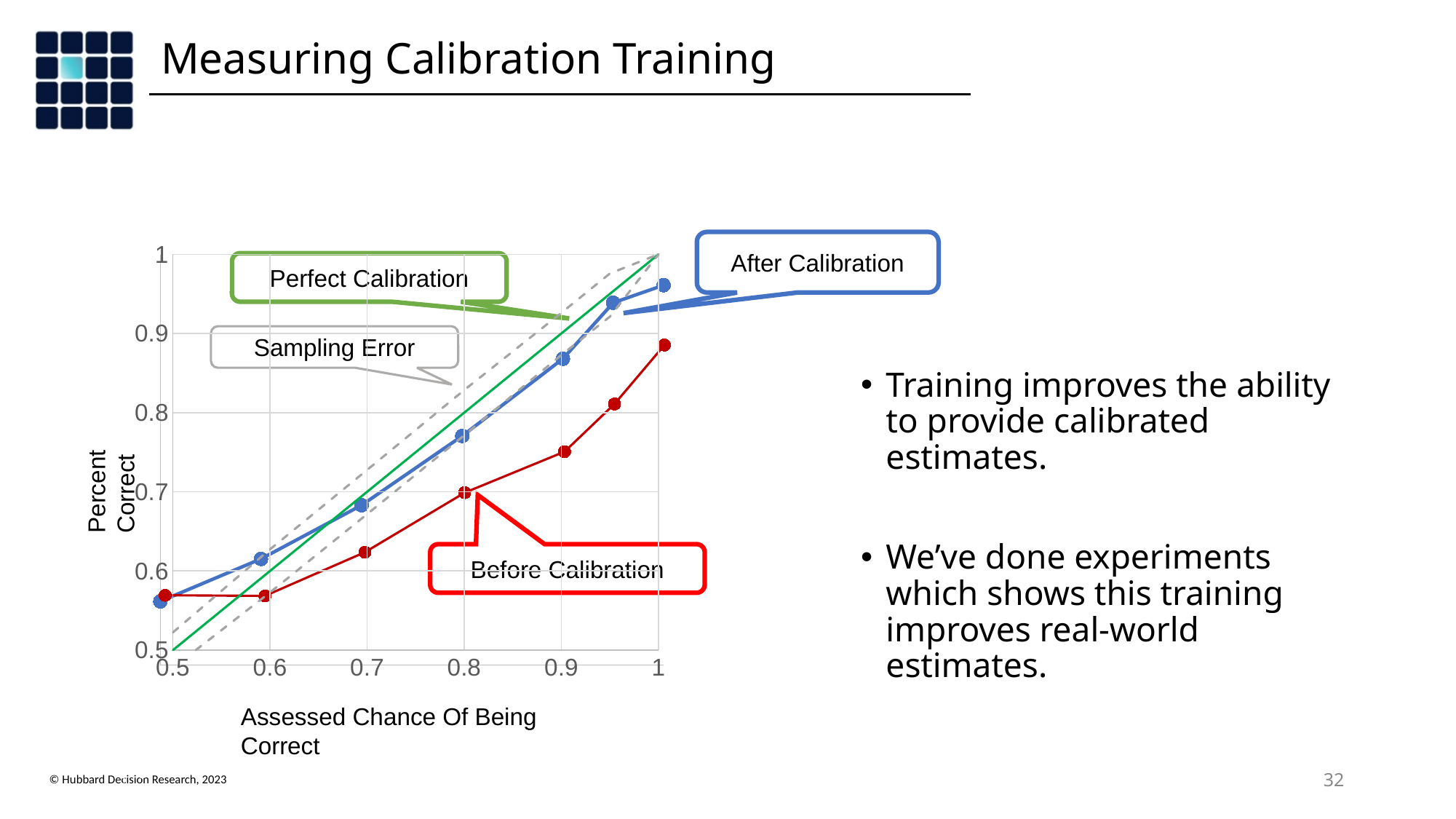
Is the Before Calibration value at an assessed chance of 1 greater or less than 0.9? less Does the Before Calibration line generally rise or fall as the assessed chance of being correct increases? rise What kind of chart is shown on the slide? line chart At an assessed chance of 0.9, which line has the higher percent correct, After Calibration or Before Calibration? After Calibration Is the After Calibration value at an assessed chance of 0.9 greater or less than 0.8? greater Is the Before Calibration value at an assessed chance of 0.9 greater or less than 0.8? less What is the title of the x axis of the chart? Assessed Chance Of Being Correct At an assessed chance of 1, which line has the higher percent correct, Before Calibration or After Calibration? After Calibration Does the After Calibration line generally rise or fall as the assessed chance of being correct increases? rise What is the title of the y axis of the chart? Percent Correct